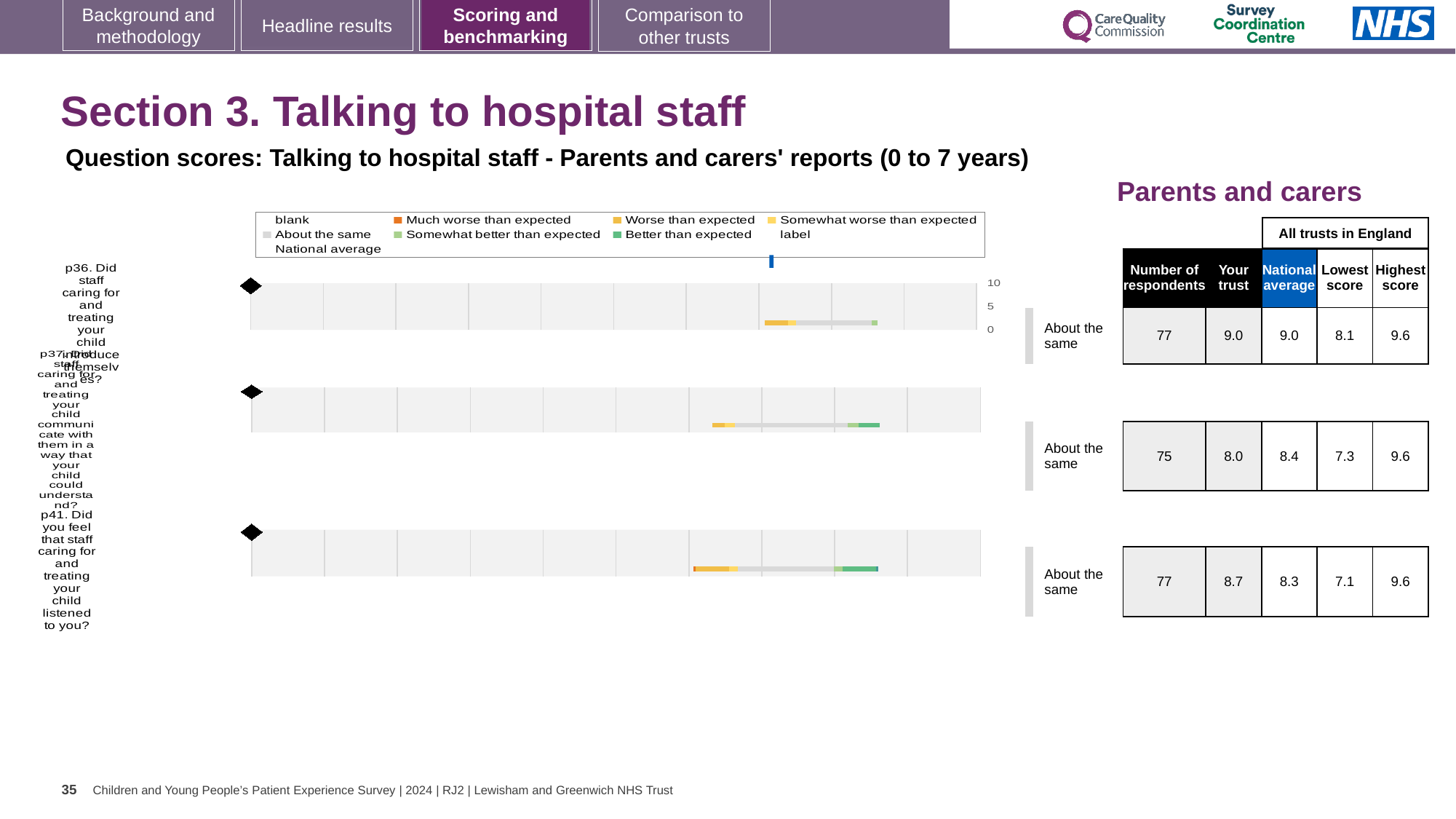
How many respondents answered p37? 75 What is the national average score for p41 (Did you feel that staff listened to you?)? 8.3 What benchmark category is shown for all three questions on this slide? About the same What is the difference between the 'Your trust' score and the national average for p41? 0.4 What is the lowest score across all trusts in England for p37? 7.3 How many survey questions (bars) are plotted in the chart? 3 Which question has the lowest 'Your trust' score? p37 What is the 'Your trust' score for p36 (Did staff caring for and treating your child introduce themselves?)? 9.0 For p37, which is larger: the 'Your trust' score or the national average? National average Which question has the highest 'Your trust' score? p36 What is the 'Your trust' score for p37 (Did staff communicate with your child in a way they could understand?)? 8.0 What kind of chart is used to show the question scores on this slide? bar chart